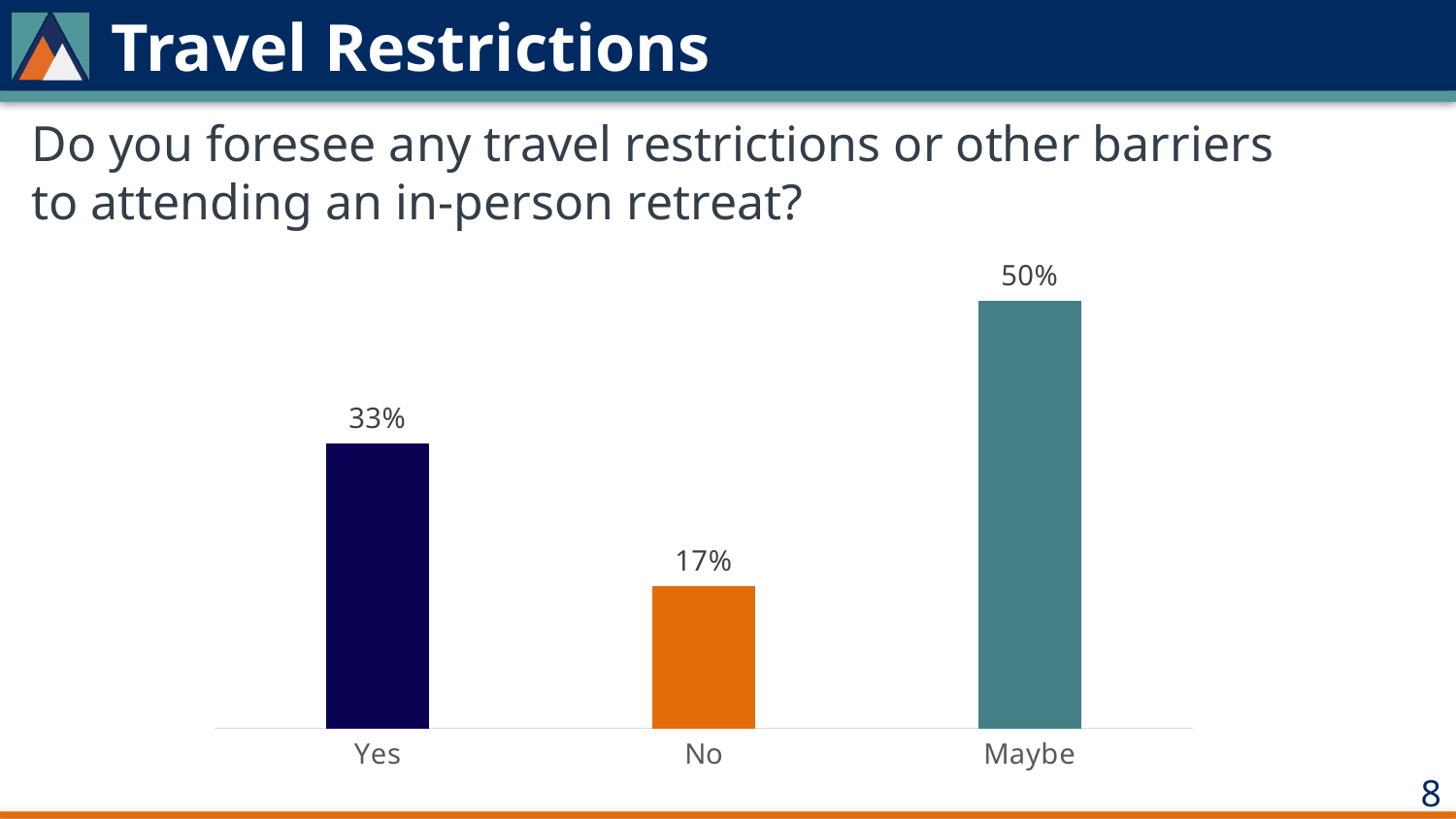
What is the difference in percentage points between "Maybe" and "Yes"? 17 How many response categories are shown in the chart? 3 What kind of chart is shown on the slide? Bar chart Which response category has the highest percentage? Maybe What percentage of respondents answered "Yes"? 33% What is the difference in percentage points between "Yes" and "No"? 16 What percentage of respondents answered "Maybe"? 50% Which is larger, the value for "Yes" or the value for "No"? Yes Which response category has the lowest percentage? No What colour is the bar for "No"? Orange What percentage of respondents answered "No"? 17% What question does the chart present responses to? Do you foresee any travel restrictions or other barriers to attending an in-person retreat?